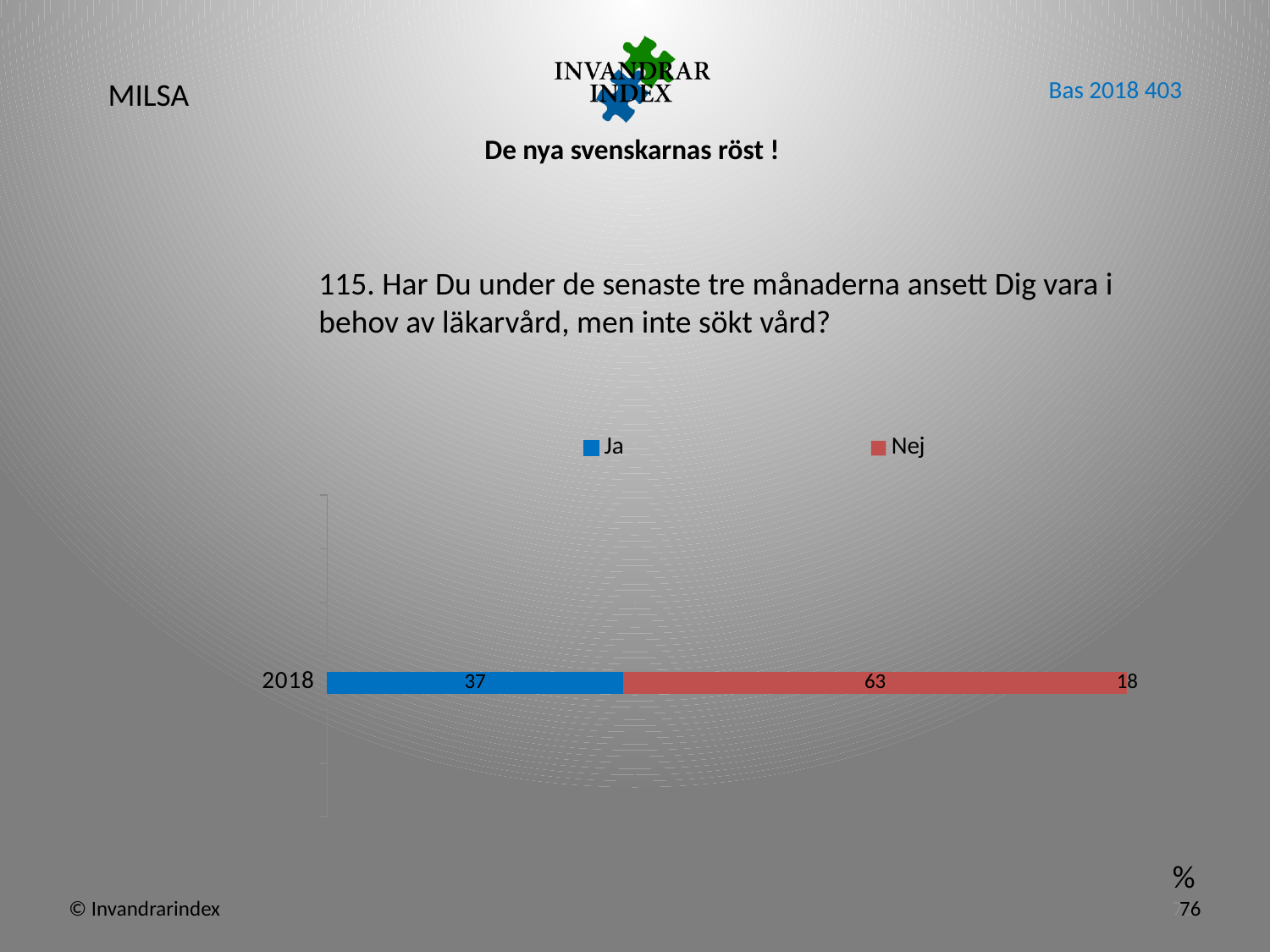
What colour represents the Ja series in the chart? Blue Which series has the larger value in 2018, Ja or Nej? Nej How many series does the legend list? 2 What is the value for Nej in 2018? 63 Which series has the highest value in 2018? Nej What kind of chart is shown on the slide? Stacked bar chart What is the difference between the Nej value and the Ja value in 2018? 26 What is the value for Ja in 2018? 37 How many categories are shown on the vertical axis of the chart? 1 Which year is shown as the category on the chart? 2018